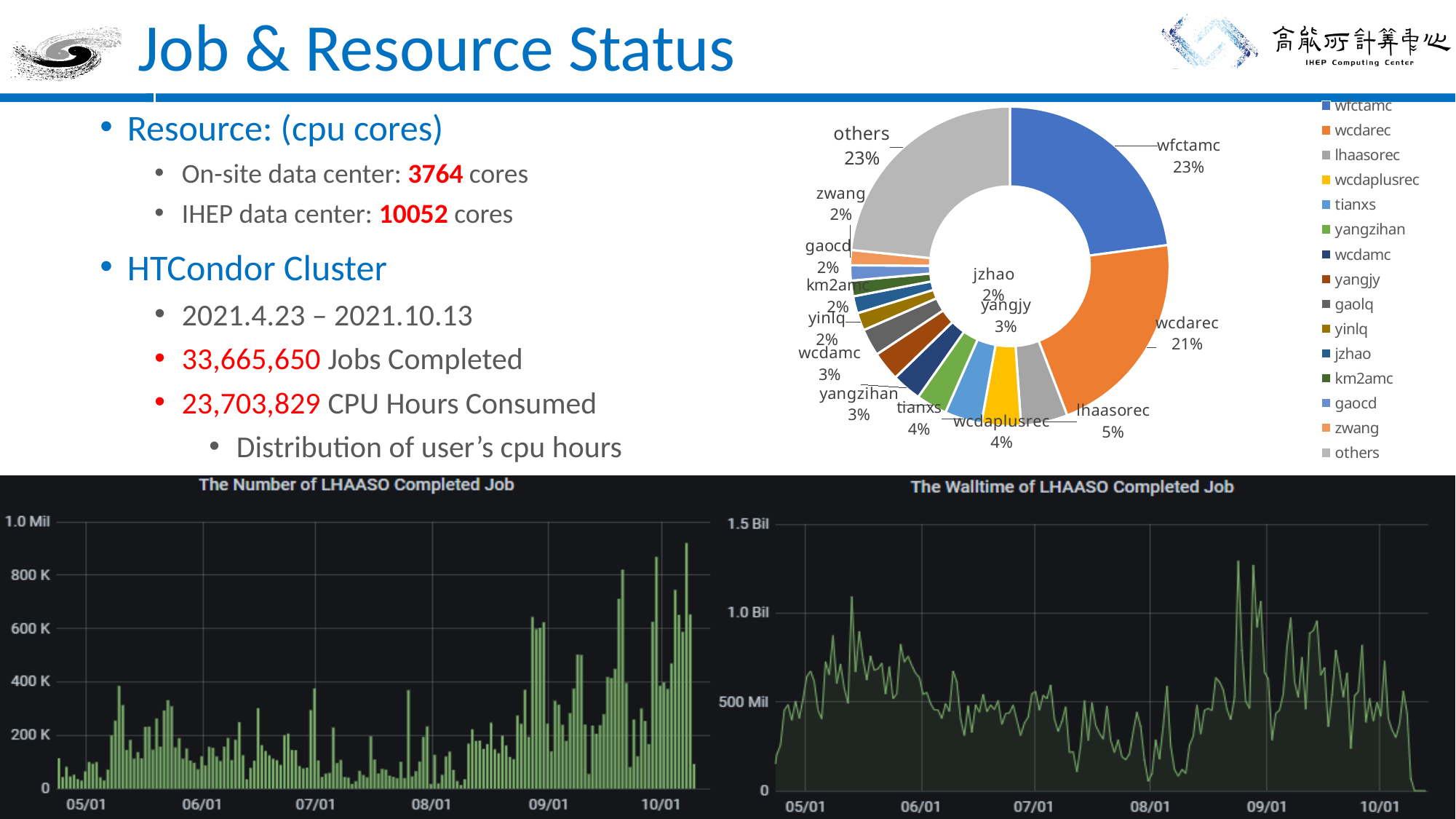
In the doughnut chart of user CPU hours, what share does wfctamc have? 23% In the doughnut chart of user CPU hours, which has the larger share, lhaasorec or tianxs? lhaasorec In the doughnut chart of user CPU hours, which has the larger share, wfctamc or wcdarec? wfctamc In 'The Number of LHAASO Completed Job' chart, is the highest bar near 10/01 greater or less than 800 K? greater In the doughnut chart of user CPU hours, what is the difference in percentage points between wfctamc and wcdarec? 2% What kind of chart is 'The Number of LHAASO Completed Job'? Bar chart In 'The Number of LHAASO Completed Job' chart, do the values generally rise or fall from 05/01 to 10/01? Rise In the doughnut chart of user CPU hours, what share does wcdarec have? 21% What kind of chart is 'The Walltime of LHAASO Completed Job'? Line chart How many entries does the legend of the doughnut chart of user CPU hours list? 15 In the doughnut chart of user CPU hours, what colour is the wcdarec slice? Orange In the doughnut chart of user CPU hours, what share does lhaasorec have? 5%